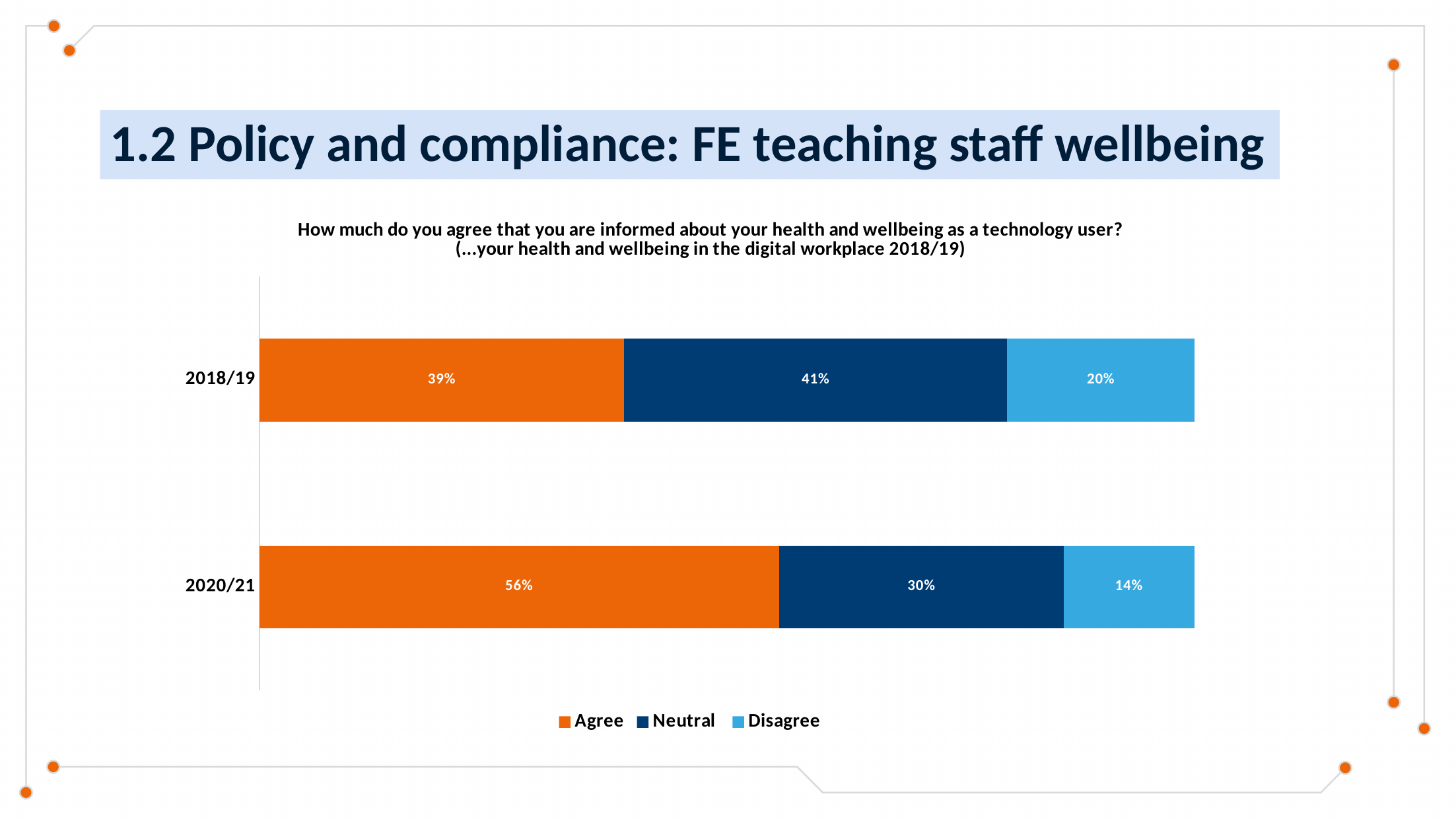
What percentage disagreed in 2020/21? 14% Which year has the higher Agree percentage? 2020/21 What is the Neutral value for 2018/19? 41% How many year categories are shown on the chart? 2 What is the total of the 2018/19 stacked bar? 100% By how many percentage points did the Agree share increase from 2018/19 to 2020/21? 17 How many series does the legend list? 3 What kind of chart is shown on the slide? Stacked bar chart Is the Neutral value larger in 2018/19 or 2020/21? 2018/19 Which colour represents the Agree series in the legend? Orange Which year has the lower Disagree percentage? 2020/21 What percentage of respondents agreed in 2020/21? 56%